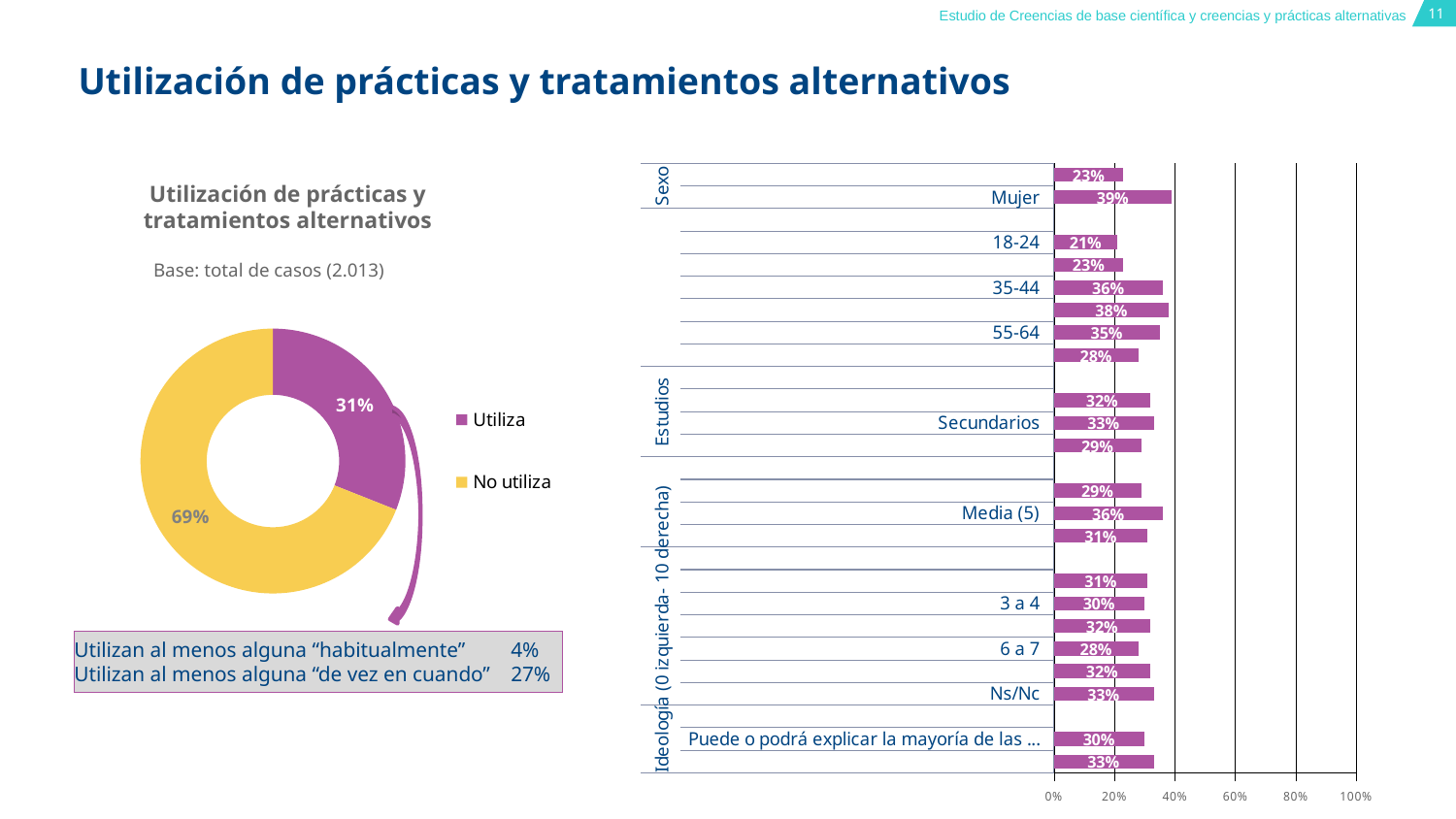
How many entries does the legend of the donut chart on the left list? 2 In the bar chart on the right, which category has the lowest value? 18-24 In the bar chart on the right, which category has the highest value? Mujer In the bar chart on the right, what is the value for "Secundarios"? 33% In the donut chart on the left, what percentage is shown for "No utiliza"? 69% In the bar chart on the right, what is the value for "18-24"? 21% In the bar chart on the right, what is the value for "Mujer"? 39% What kind of chart is the chart on the right side of the slide? Bar chart In the donut chart on the left, which slice is larger, "Utiliza" or "No utiliza"? No utiliza In the donut chart on the left, what percentage is shown for "Utiliza"? 31% In the bar chart on the right, what is the value for "Media (5)"? 36% In the bar chart on the right, what is the difference between the values for "Mujer" and "18-24"? 18 percentage points